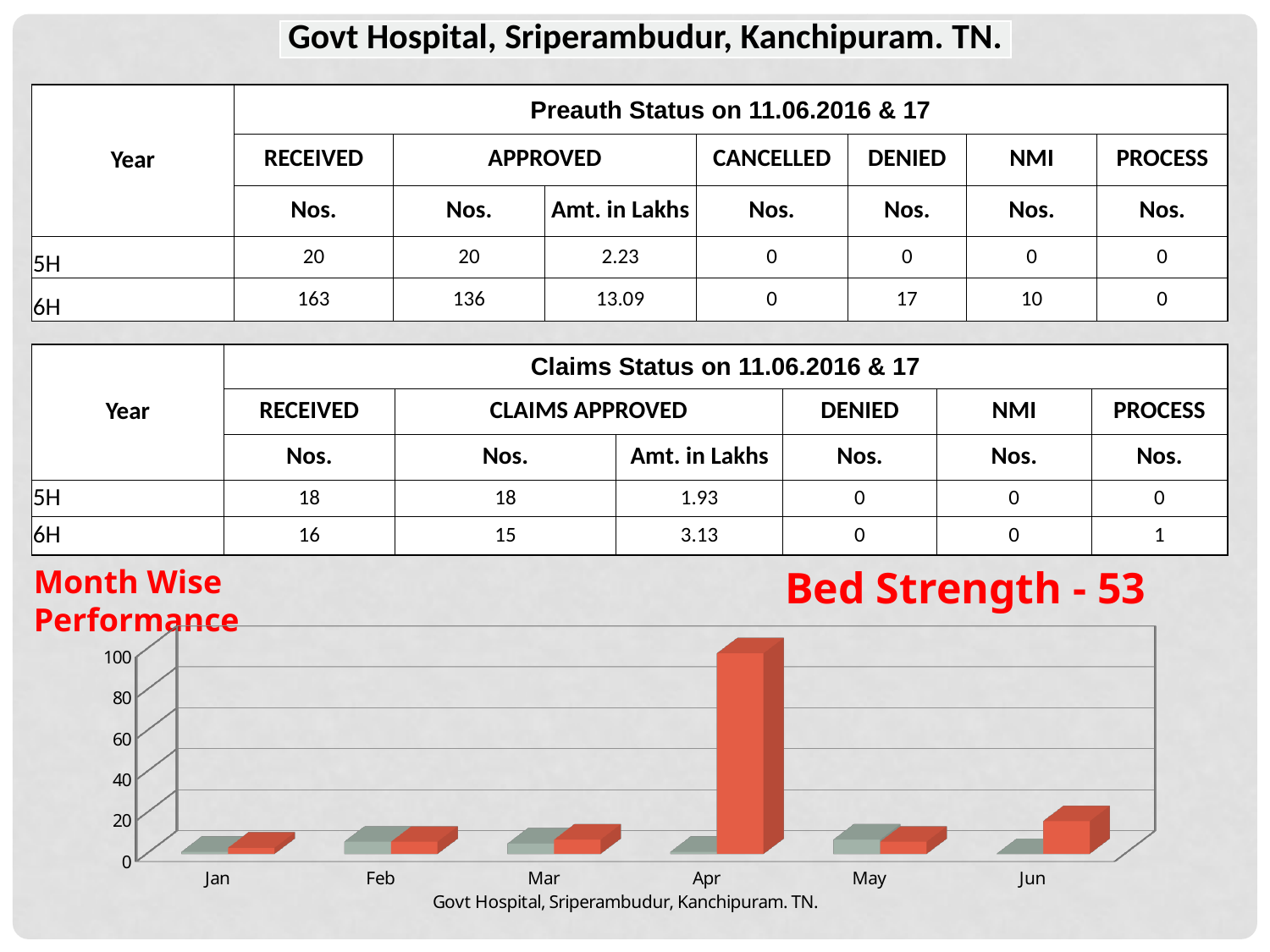
How many months are shown on the x axis of the Month Wise Performance chart? 6 How many bars are plotted for each month in the Month Wise Performance chart? 2 What is the highest value shown on the vertical axis of the Month Wise Performance chart? 100 In the Month Wise Performance chart, which month has the tallest bar? Apr In the Month Wise Performance chart, which month has a taller orange bar, Jun or May? Jun In the Month Wise Performance chart, is the tallest bar for Apr greater or less than 80? greater What kind of chart is shown under the heading 'Month Wise Performance'? bar chart In the Month Wise Performance chart, which month has a taller bar, Apr or Feb? Apr In the Month Wise Performance chart, is the tallest bar for Jun greater or less than 40? less What text appears below the x axis of the Month Wise Performance chart? Govt Hospital, Sriperambudur, Kanchipuram. TN. In the Month Wise Performance chart, is the tallest bar for Jan greater or less than 20? less